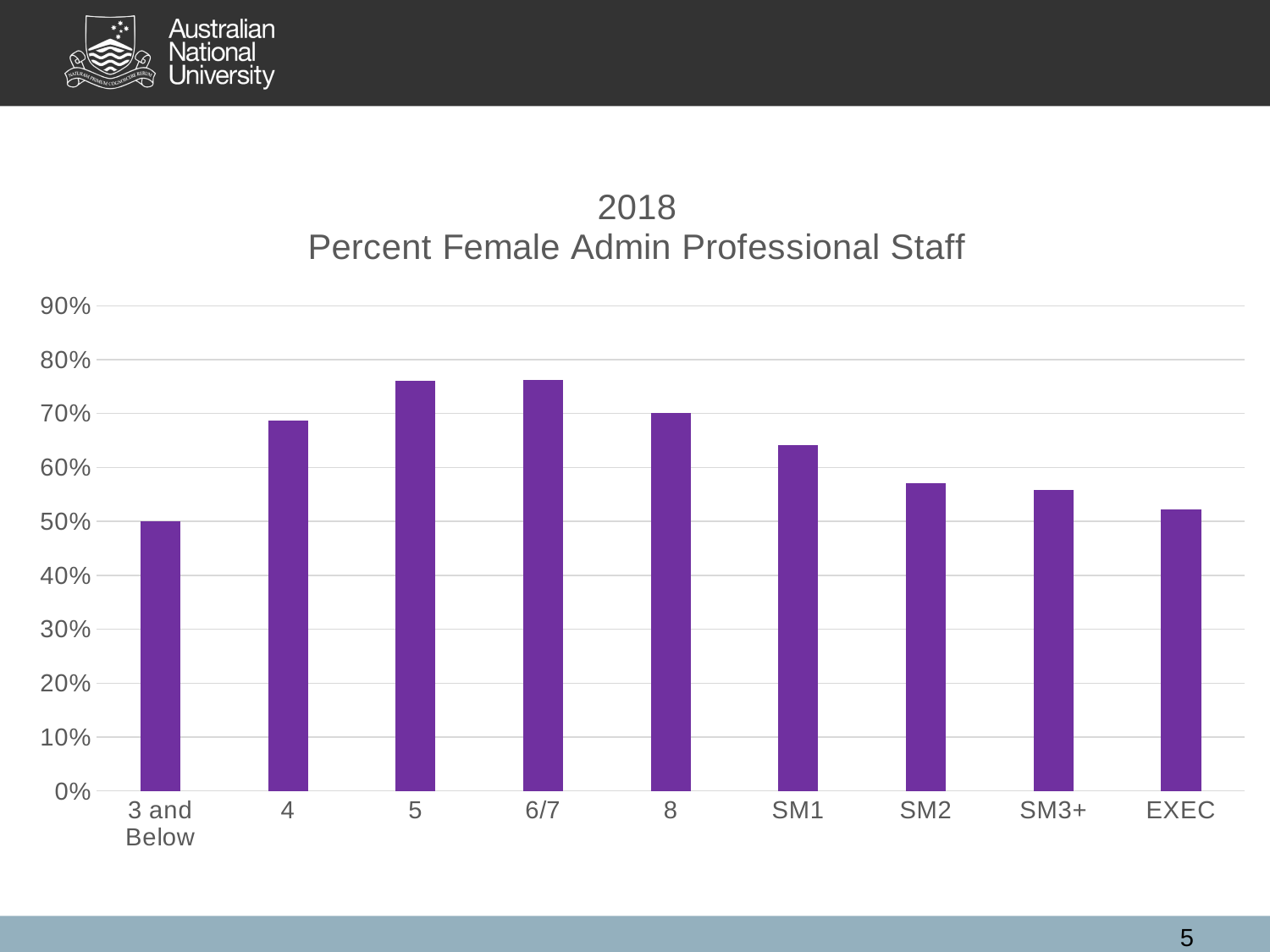
What kind of chart is shown on the slide? bar chart Is the value for 3 and Below greater or less than 60%? less How many categories are shown on the x axis of the chart? 9 Which has the higher value, level 8 or SM2? 8 Which has the higher value, level 4 or SM1? 4 Is the value for 6/7 greater or less than 80%? less What is the title of the chart? 2018 Percent Female Admin Professional Staff Is the value for SM1 greater or less than 60%? greater From level 8 through to EXEC, do the values rise or fall along the x axis? fall